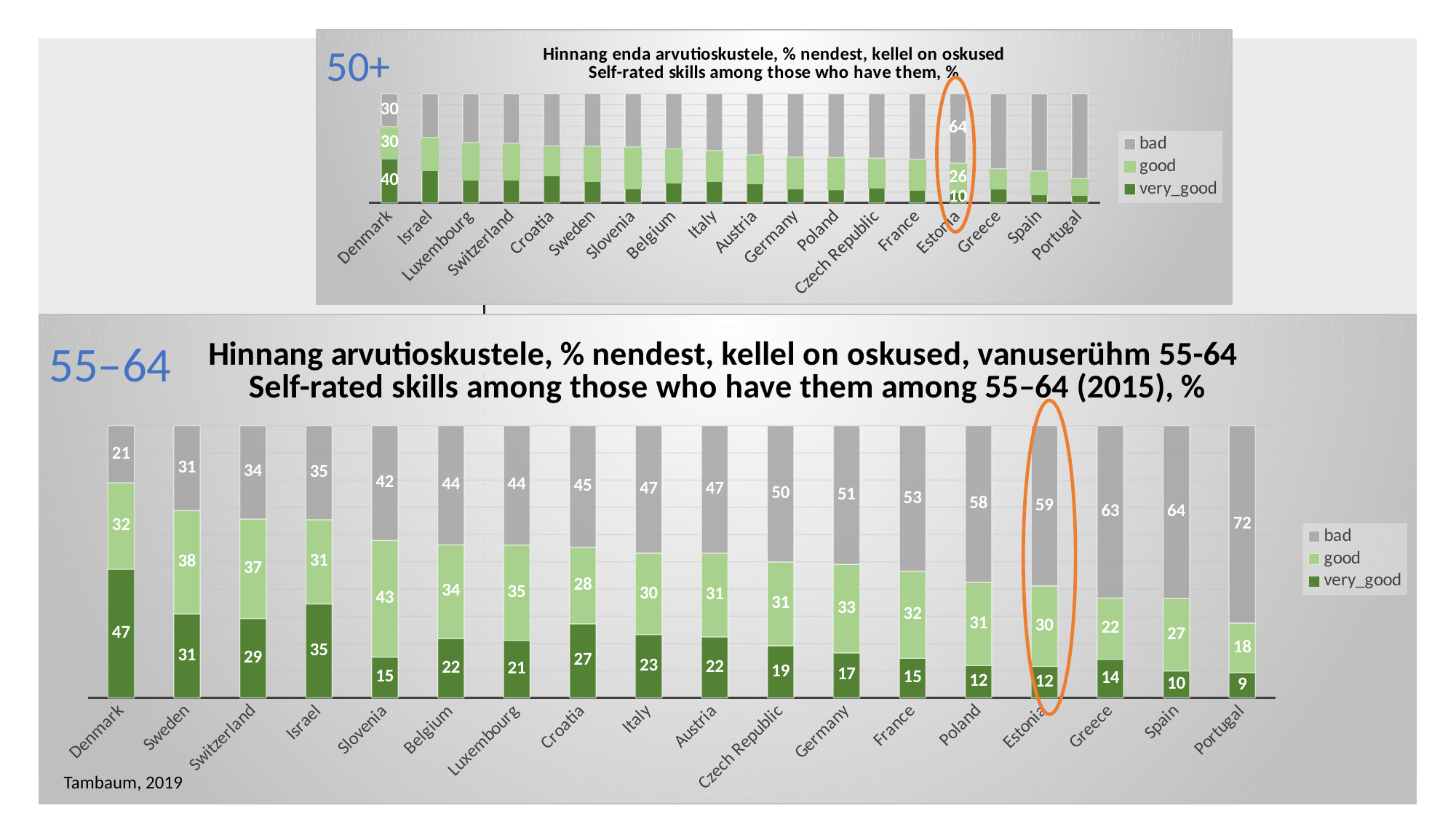
In the top chart (50+), what is the 'bad' value for Estonia? 64 In the bottom chart (55–64), what is the 'bad' value for Portugal? 72 In the bottom chart (55–64), what is the 'very_good' value for Denmark? 47 In the bottom chart (55–64), what is the difference between the 'bad' values for Estonia and Denmark? 38 In the bottom chart (55–64), which country has the highest 'bad' value? Portugal In the bottom chart (55–64), which country has the lowest 'very_good' value? Portugal What kind of chart is the bottom chart (55–64)? Stacked bar chart In the bottom chart (55–64), what is the 'good' value for Estonia? 30 In the top chart (50+), what is the 'very_good' value for Denmark? 40 In the bottom chart (55–64), which is larger: the 'good' value for Slovenia or the 'good' value for Sweden? Slovenia In the top chart (50+), how many series does the legend list? 3 In the bottom chart (55–64), how many countries are shown? 18